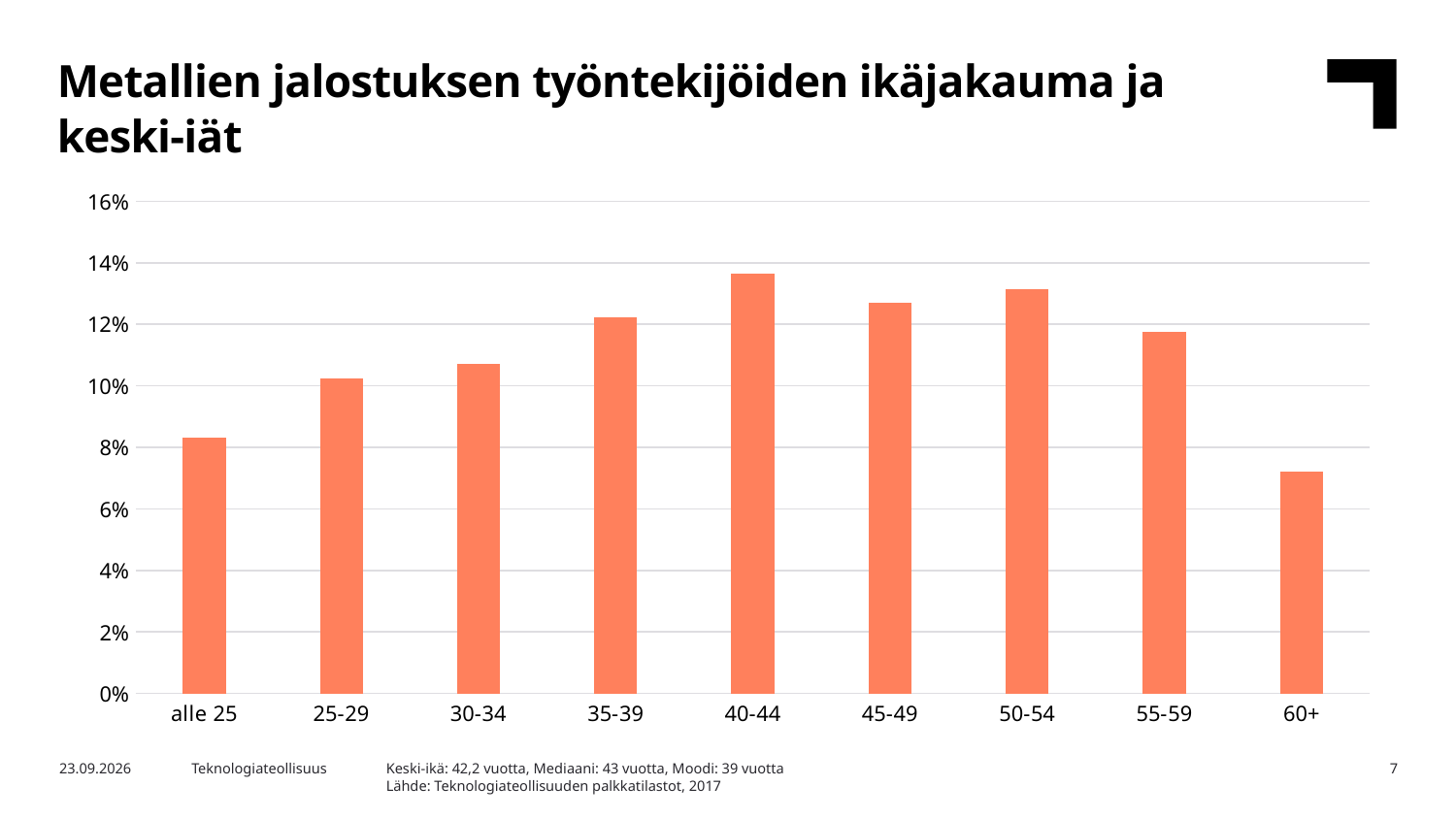
Do the values rise or fall from alle 25 to 40-44? rise According to the note below the chart, what is the keski-ikä (average age)? 42,2 vuotta Which age group has the lowest share of workers? 60+ Is the value for 55-59 greater or less than 12%? less Which is larger, the value for 30-34 or the value for 55-59? 55-59 Is the value for 60+ greater or less than 8%? less Is the value for 35-39 greater or less than 12%? greater What kind of chart is shown on the slide? bar chart Which age group has the highest share of workers? 40-44 How many age groups are shown on the x axis? 9